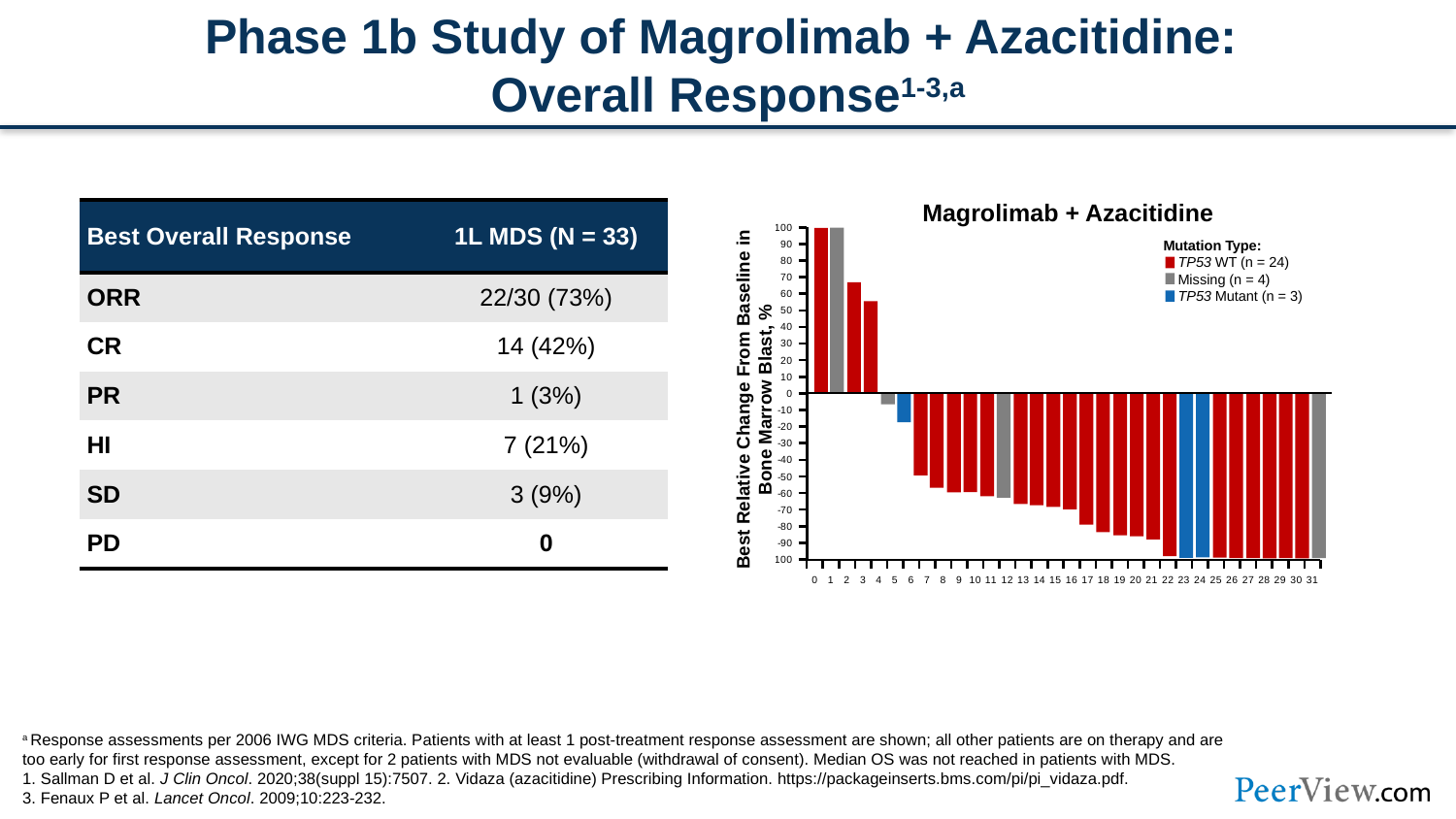
Is the value for patient 12 greater or less than -50? less Is the value for patient 7 greater or less than -40? less How many mutation types does the chart legend list? 3 What kind of chart is shown on the slide? bar chart Is the value for patient 6 greater or less than -20? less What is the title of the chart? Magrolimab + Azacitidine According to the legend, how many patients are TP53 WT? n = 24 Which has the larger value, patient 6 or patient 7? patient 6 Do the bar values rise or fall moving from left to right along the x axis? fall Which has the larger value, patient 2 or patient 3? patient 2